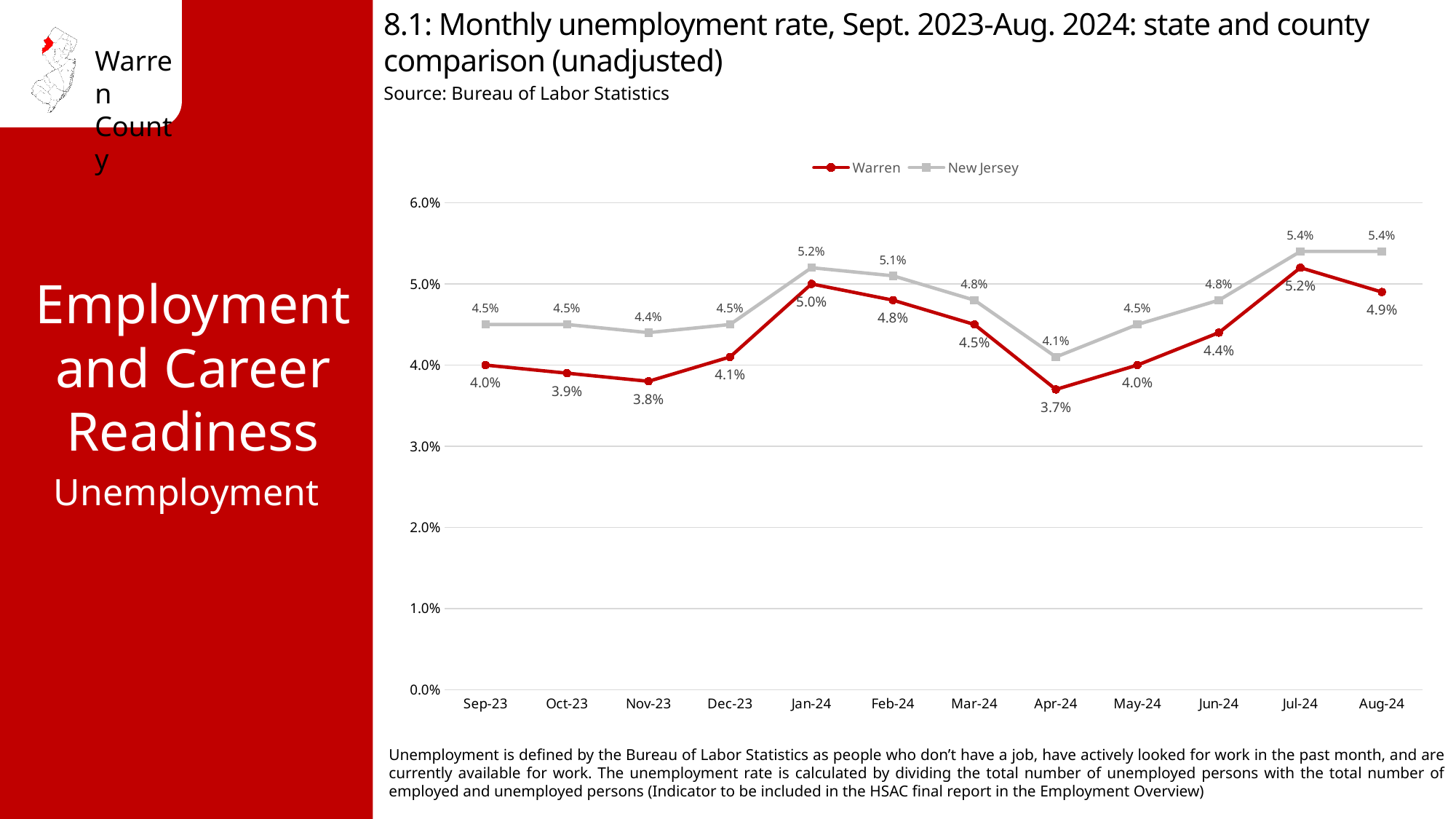
What kind of chart is shown on the slide? Line chart What is the difference between the New Jersey and Warren unemployment rates in Aug-24? 0.5% What is the New Jersey unemployment rate for Jan-24? 5.2% In which month does the New Jersey series reach its lowest value? Apr-24 In which month does the Warren series reach its highest value? Jul-24 In which month does the Warren series reach its lowest value? Apr-24 Which series has the higher value in Mar-24, Warren or New Jersey? New Jersey What is the Warren unemployment rate for Jul-24? 5.2% How many series does the legend list? 2 What is the Warren unemployment rate for Apr-24? 3.7% Does the Warren series rise or fall from Sep-23 to Nov-23? Fall How many months are plotted on the x axis? 12